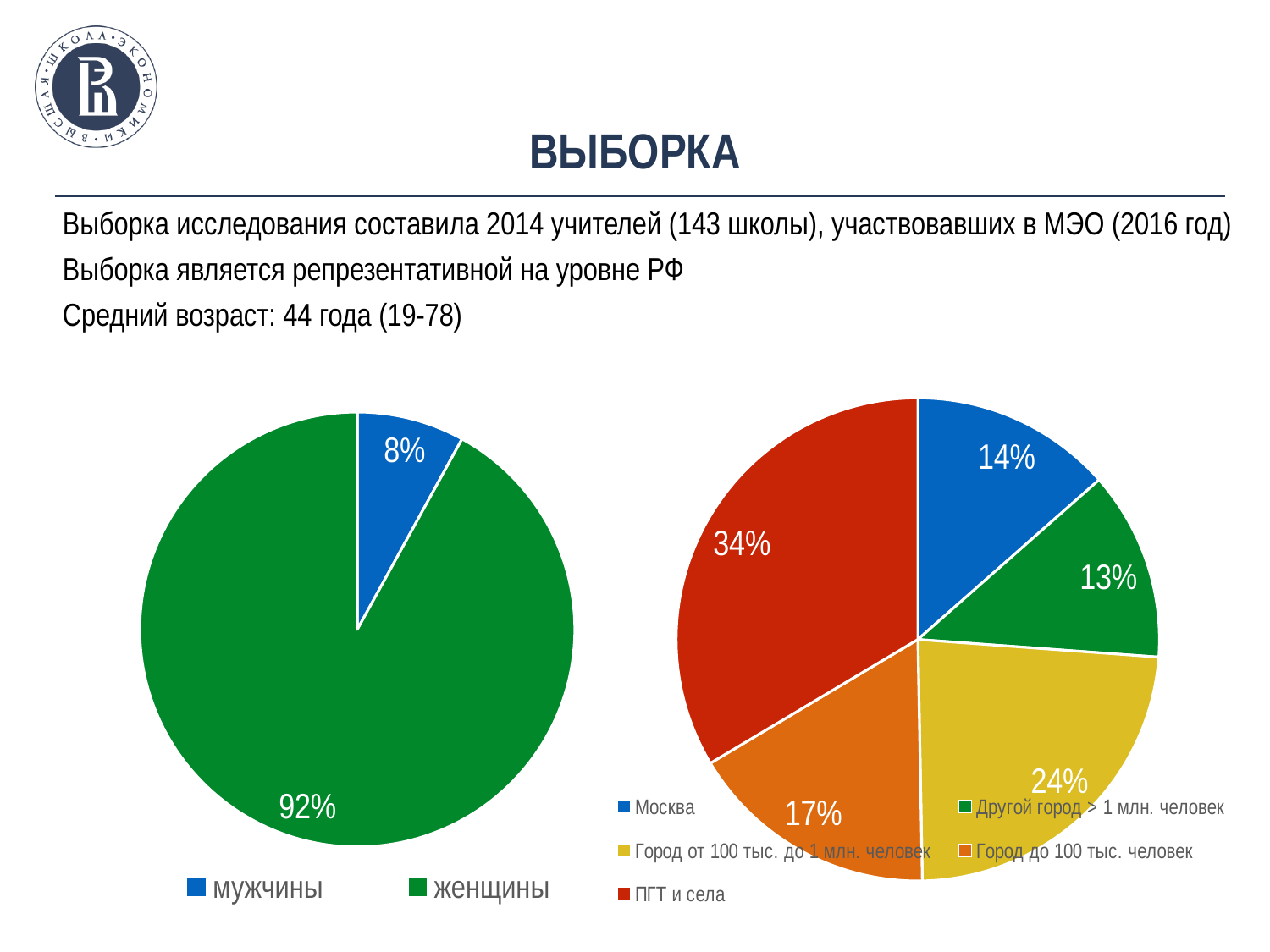
In the right pie chart, what share is labelled for Москва? 14% In the right pie chart, what share is labelled for ПГТ и села? 34% How many categories does the legend of the right pie chart list? 5 In the right pie chart, which category has the largest share? ПГТ и села What kind of chart is the chart on the right of the slide? pie chart In the left pie chart, what is the difference between the shares for женщины and мужчины? 84% In the left pie chart, what share is labelled for мужчины? 8% In the left pie chart, how many slices are there? 2 In the right pie chart, which is larger: the share for Город до 100 тыс. человек or the share for Москва? Город до 100 тыс. человек In the right pie chart, which category has the smallest share? Другой город > 1 млн. человек In the right pie chart, what share is labelled for Город от 100 тыс. до 1 млн. человек? 24% In the left pie chart, what share is labelled for женщины? 92%